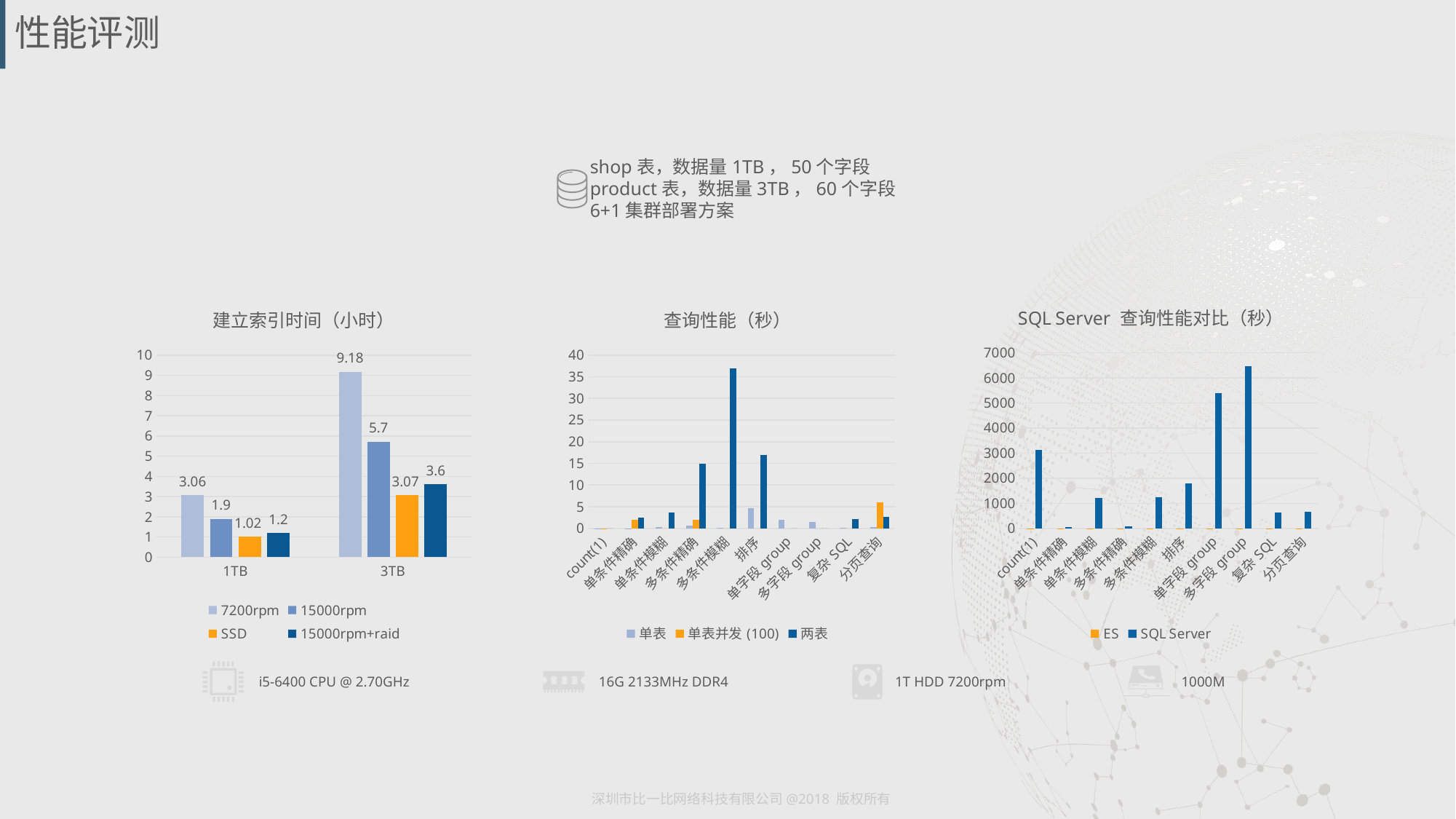
In the 查询性能（秒） chart, is the value of 两表 for 多条件模糊 greater or less than 35? greater In the SQL Server 查询性能对比（秒） chart, which category has the highest SQL Server value? 多字段 group In the 查询性能（秒） chart, which category has the highest 两表 value? 多条件模糊 In the 建立索引时间（小时） chart, which is larger at 1TB: 15000rpm or 15000rpm+raid? 15000rpm How many categories are shown on the x axis of the 查询性能（秒） chart? 10 How many series does the legend of the 建立索引时间（小时） chart list? 4 In the 建立索引时间（小时） chart, what is the value for 7200rpm at 3TB? 9.18 What kind of chart is the SQL Server 查询性能对比（秒） chart? bar chart In the 建立索引时间（小时） chart, what is the value for SSD at 1TB? 1.02 In the 建立索引时间（小时） chart, what is the difference between 7200rpm and 15000rpm at 3TB? 3.48 In the SQL Server 查询性能对比（秒） chart, is the SQL Server value for 多字段 group greater or less than 6000? greater In the 建立索引时间（小时） chart, which series has the lowest value at 3TB? SSD